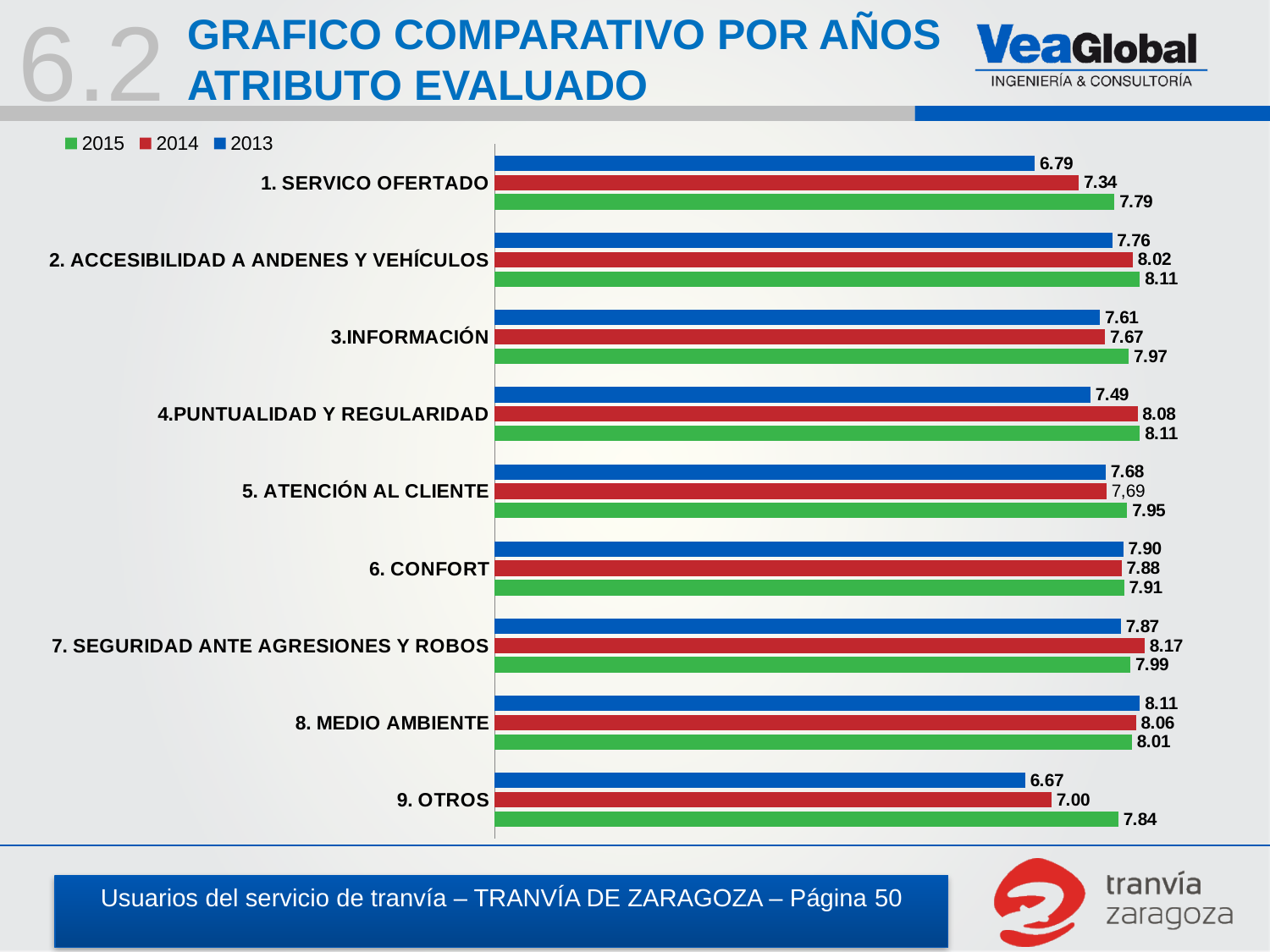
What is the difference between the 2014 and 2013 values for 1. SERVICO OFERTADO? 0.55 How many attribute categories are plotted on the chart? 9 What kind of chart is shown on the slide? bar chart Which colour represents the 2014 series in the legend? red For 8. MEDIO AMBIENTE, which year has the larger value, 2013 or 2015? 2013 What is the 2013 value for 4.PUNTUALIDAD Y REGULARIDAD? 7.49 What is the 2015 value for 1. SERVICO OFERTADO? 7.79 Which category has the lowest 2013 value? 9. OTROS What is the difference between the 2015 and 2013 values for 9. OTROS? 1.17 What is the 2014 value for 7. SEGURIDAD ANTE AGRESIONES Y ROBOS? 8.17 How many series does the legend list? 3 Which category has the highest 2014 value? 7. SEGURIDAD ANTE AGRESIONES Y ROBOS